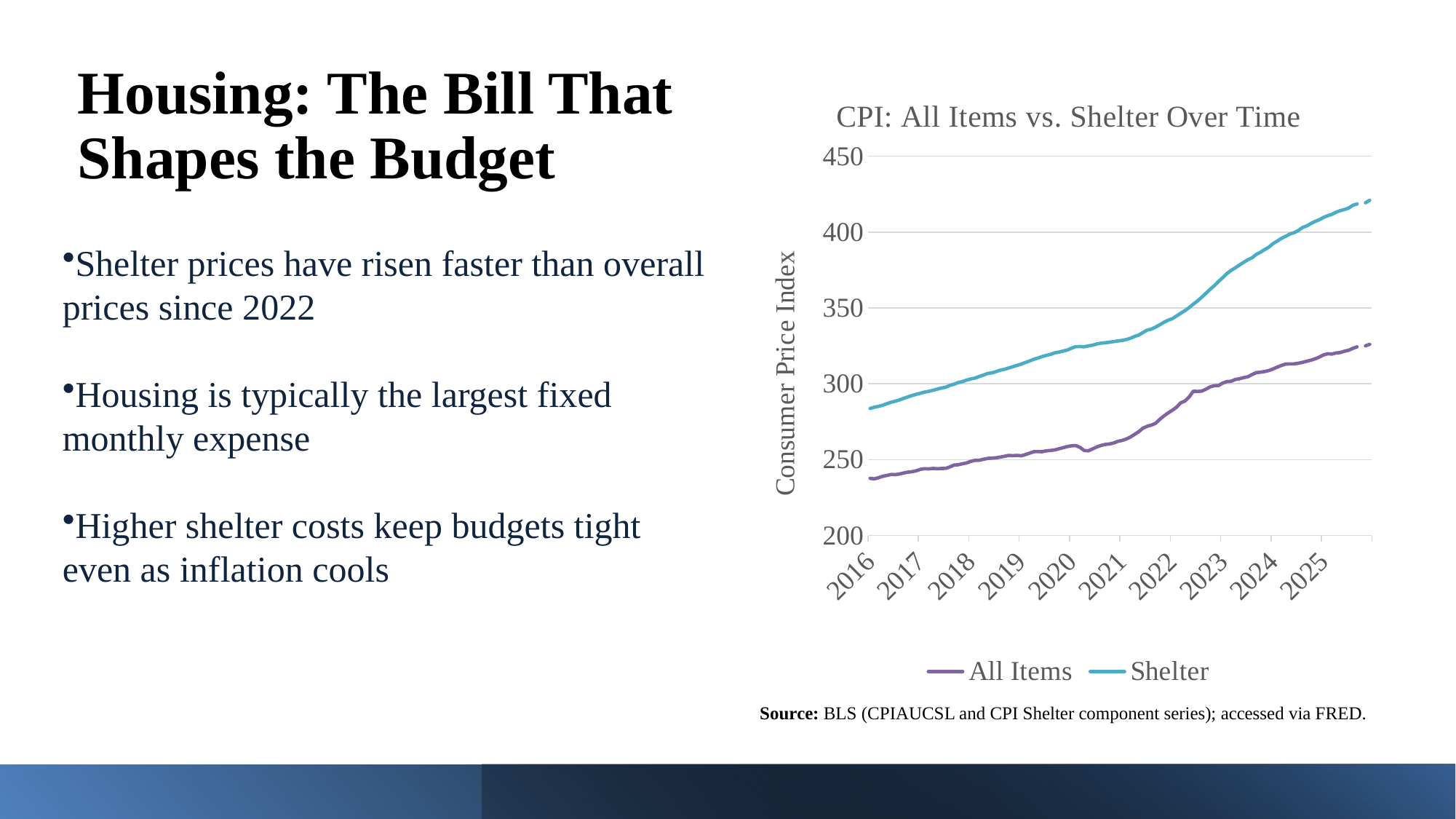
Do the values for the All Items series rise or fall from 2016 to 2025? Rise Is the value for Shelter in 2025 greater or less than 400? greater Which series is higher in 2025, All Items or Shelter? Shelter What kind of chart is shown on the slide? Line chart Do the values for the Shelter series rise or fall from 2016 to 2025? Rise Is the value for Shelter in 2016 greater or less than 300? less How many year labels are shown on the horizontal axis of the chart? 10 What is the title of the chart? CPI: All Items vs. Shelter Over Time How many series does the legend of the chart list? 2 Is the value for All Items in 2025 greater or less than 300? greater What is the label on the vertical axis of the chart? Consumer Price Index